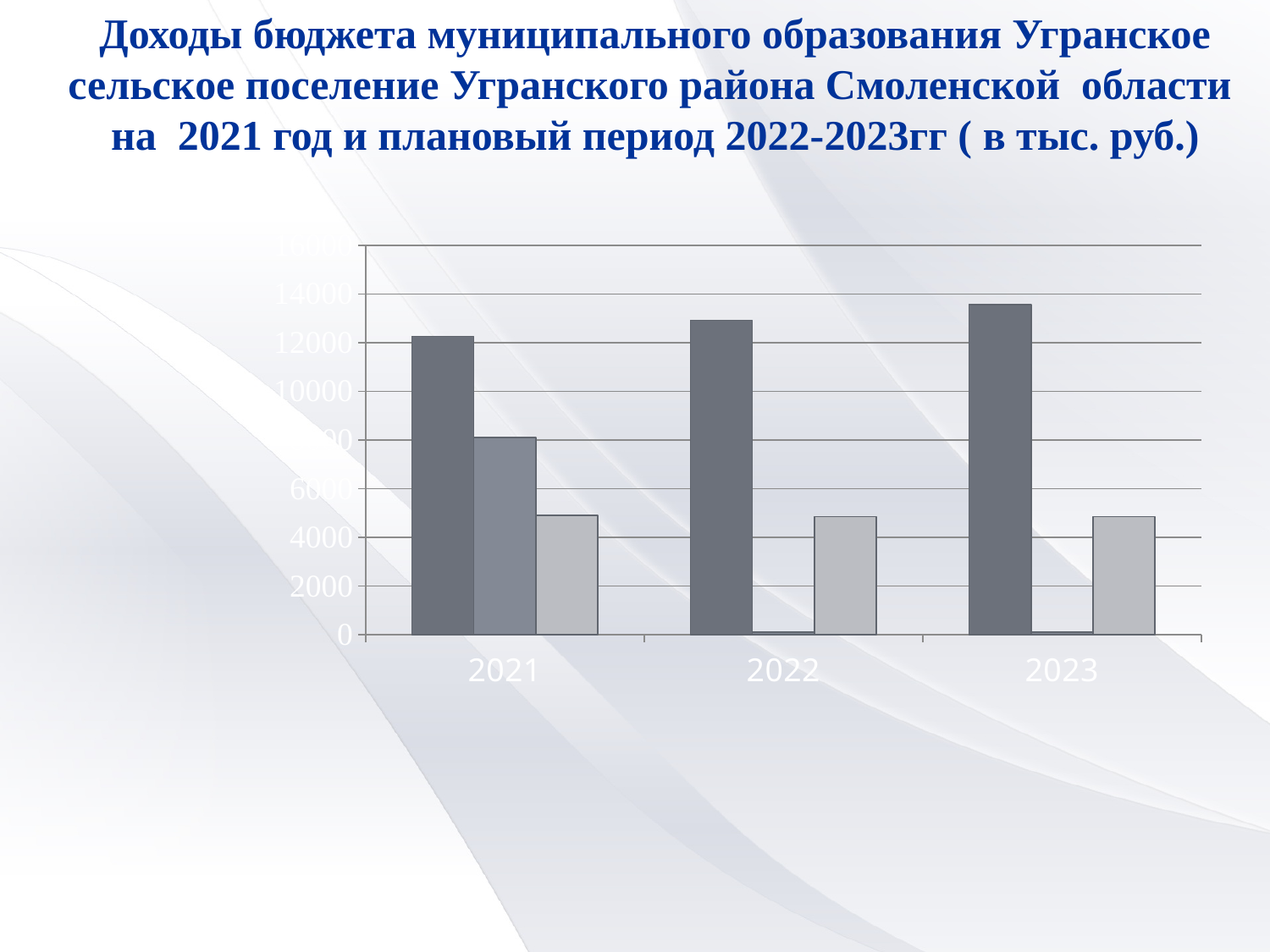
Which year has the lowest darkest (first) bar? 2021 Is the value of the darkest (first) bar for 2023 greater or less than 14000? less Which is larger for 2021: the middle (second) bar or the lightest (third) bar? the middle (second) bar What kind of chart is shown on the slide? bar chart Is the value of the middle (second) bar for 2021 greater or less than 6000? greater Is the value of the middle (second) bar for 2022 greater or less than 2000? less How many year categories are shown on the x axis? 3 Which year has the highest darkest (first) bar? 2023 Do the values of the darkest (first) bars rise or fall from 2021 to 2023? rise How many bars are plotted for each year? 3